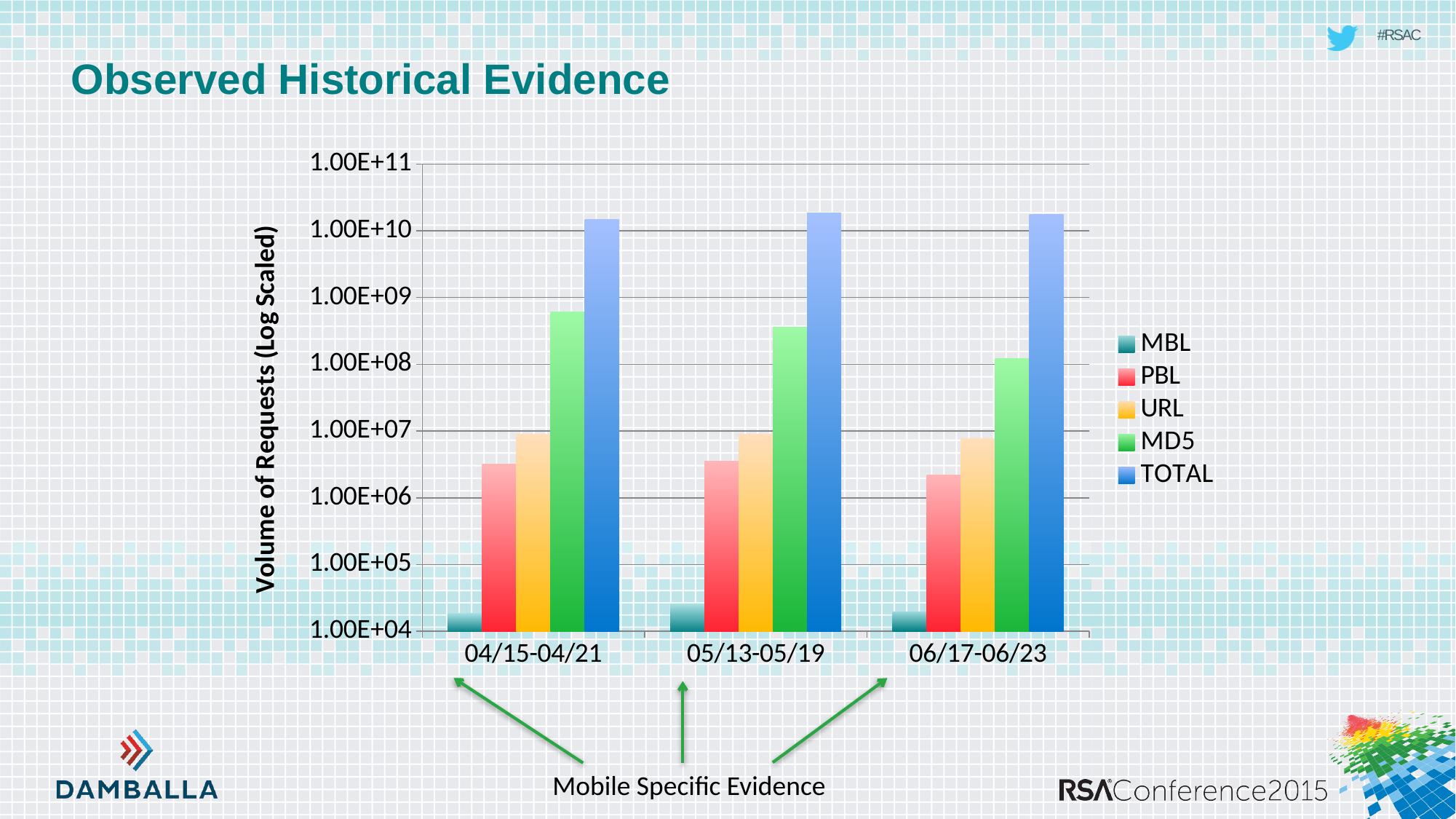
Is the PBL value for 04/15-04/21 greater or less than 1.00E+06? greater Is the TOTAL value for 04/15-04/21 greater or less than 1.00E+10? greater Which series has the lowest value in the 06/17-06/23 period? MBL What is the title of the chart's y axis? Volume of Requests (Log Scaled) Which is larger, the MD5 value for 04/15-04/21 or the MD5 value for 06/17-06/23? 04/15-04/21 Does the MD5 value rise or fall across the three periods from 04/15-04/21 to 06/17-06/23? fall Is the MBL value for 05/13-05/19 greater or less than 1.00E+05? less Which series has the highest value in the 04/15-04/21 period? TOTAL How many series does the chart's legend list? 5 How many date ranges are shown on the x axis of the chart? 3 What kind of chart is shown on the slide? bar chart